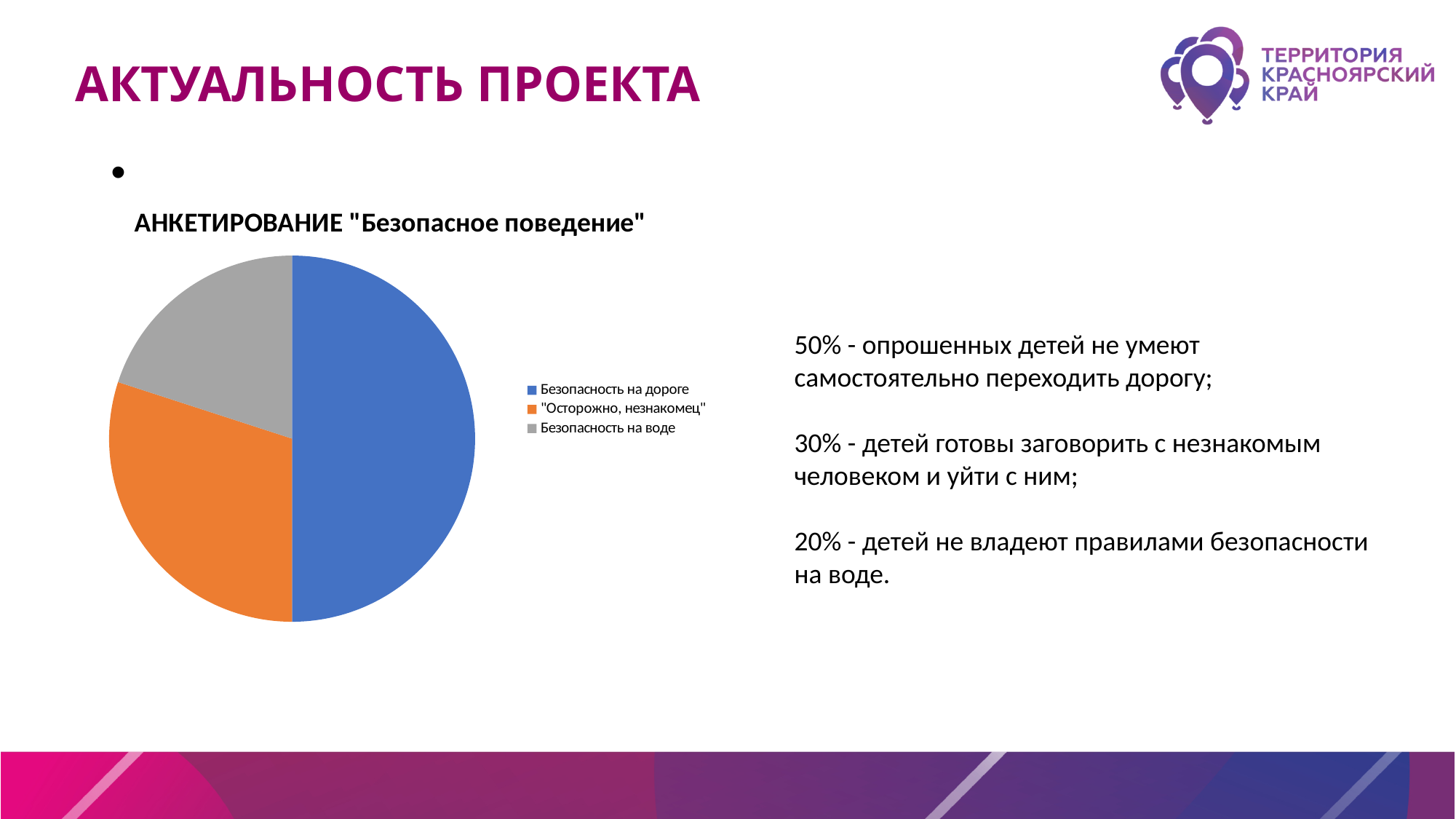
What is the title of the chart? АНКЕТИРОВАНИЕ "Безопасное поведение" Which slice is larger: Безопасность на дороге or "Осторожно, незнакомец"? Безопасность на дороге Which slice is larger: "Осторожно, незнакомец" or Безопасность на воде? "Осторожно, незнакомец" What colour is the slice for "Осторожно, незнакомец"? orange What share of the pie does the Безопасность на воде slice represent? 20% What share of the pie does the "Осторожно, незнакомец" slice represent? 30% How many slices does the pie chart have? 3 How many entries does the chart legend list? 3 What kind of chart is shown on the slide? pie chart What share of the pie does the Безопасность на дороге slice represent? 50% Which category has the smallest slice of the pie? Безопасность на воде Which category has the largest slice of the pie? Безопасность на дороге